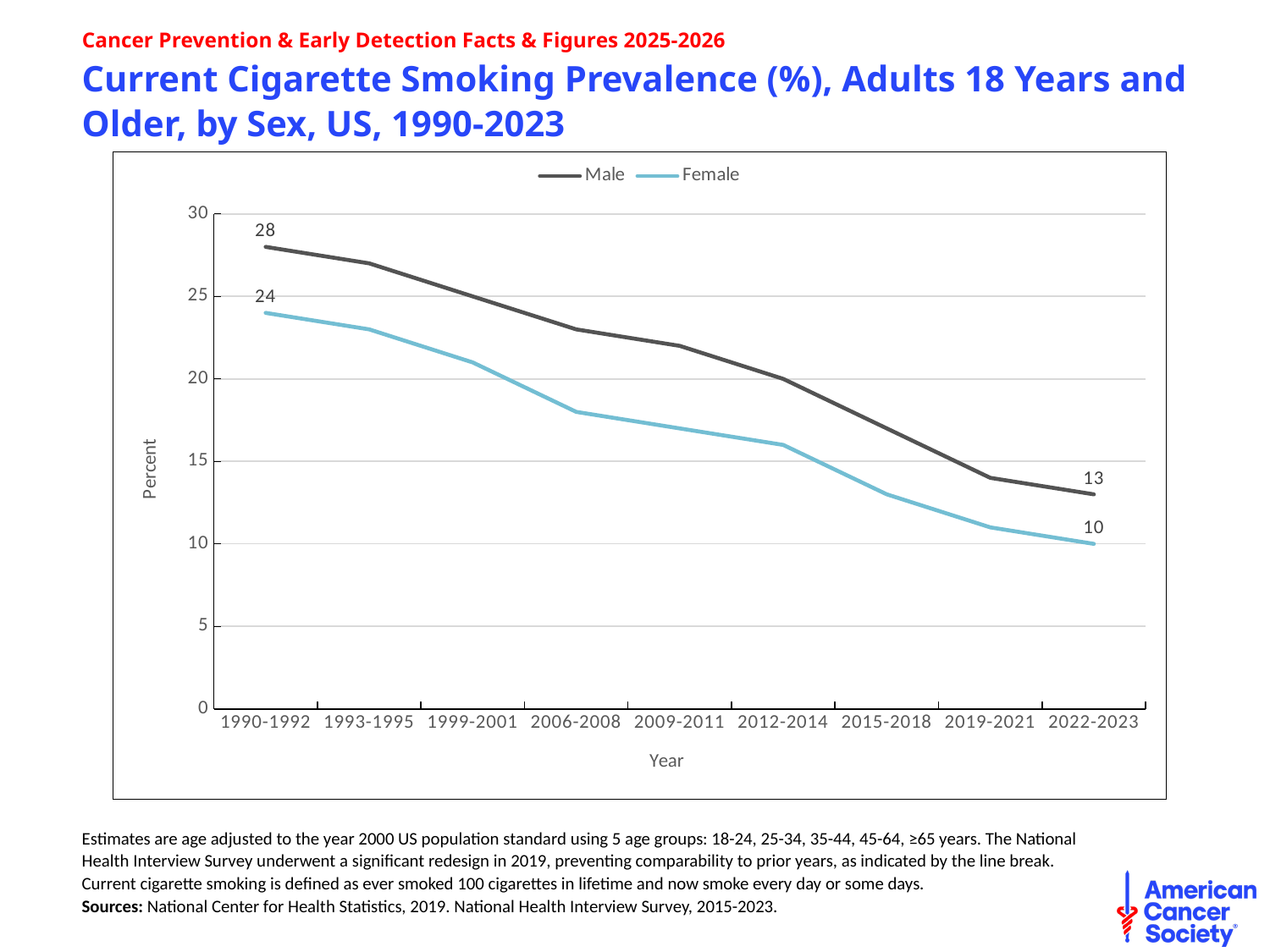
By how much did the Male value fall from 1990-1992 to 2022-2023? 15 How many year periods are shown on the x axis? 9 What is the Male smoking prevalence for 1990-1992? 28 Is the Female value for 2006-2008 greater or less than 20? less What is the Female smoking prevalence for 1990-1992? 24 What is the difference between the Male and Female values in 1990-1992? 4 What is the Female smoking prevalence for 2022-2023? 10 Is the Male value for 2019-2021 greater or less than 15? less What is the Male smoking prevalence for 2022-2023? 13 What kind of chart is shown on the slide? Line chart Which series has the higher value in 2022-2023, Male or Female? Male How many series does the legend list? 2